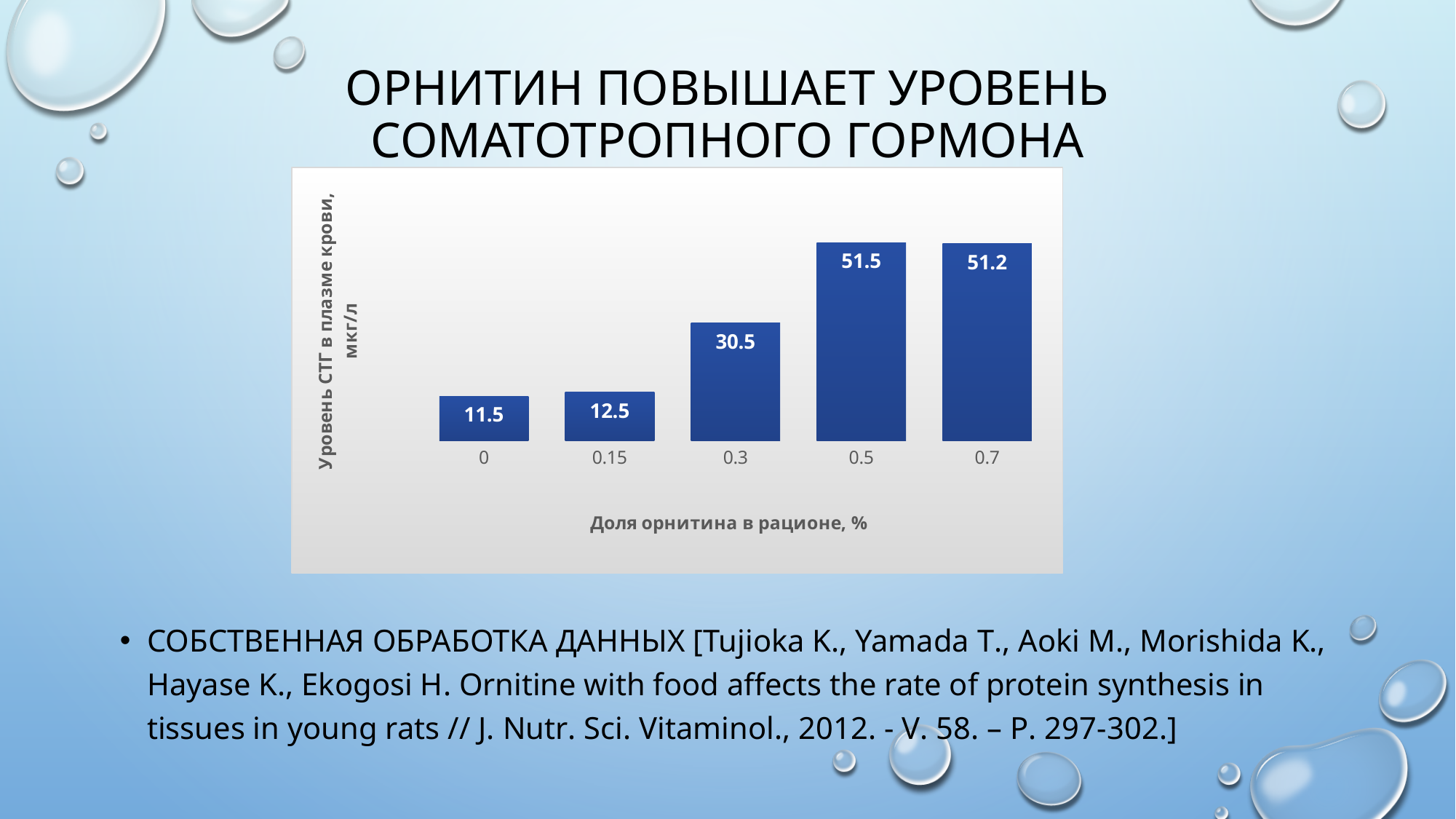
What is the difference between the values at 0.15% and 0% ornithine? 1 Which ornithine share in the diet has the highest growth hormone level? 0.5 What is the label of the x axis of the chart? Доля орнитина в рационе, % What is the plasma growth hormone level (Уровень СТГ) at 0.3% ornithine in the diet? 30.5 What kind of chart is shown on the slide? Bar chart What is the difference between the values at 0.5% and 0.3% ornithine? 21 Which ornithine share in the diet has the lowest growth hormone level? 0 What is the value shown for the 0.7% ornithine category? 51.2 How many categories (ornithine shares) are plotted on the chart? 5 Do the values generally rise or fall as the ornithine share increases from 0 to 0.5? Rise Which is larger, the value at 0.3% or the value at 0.15% ornithine? 0.3 What is the value shown for the 0% ornithine category? 11.5